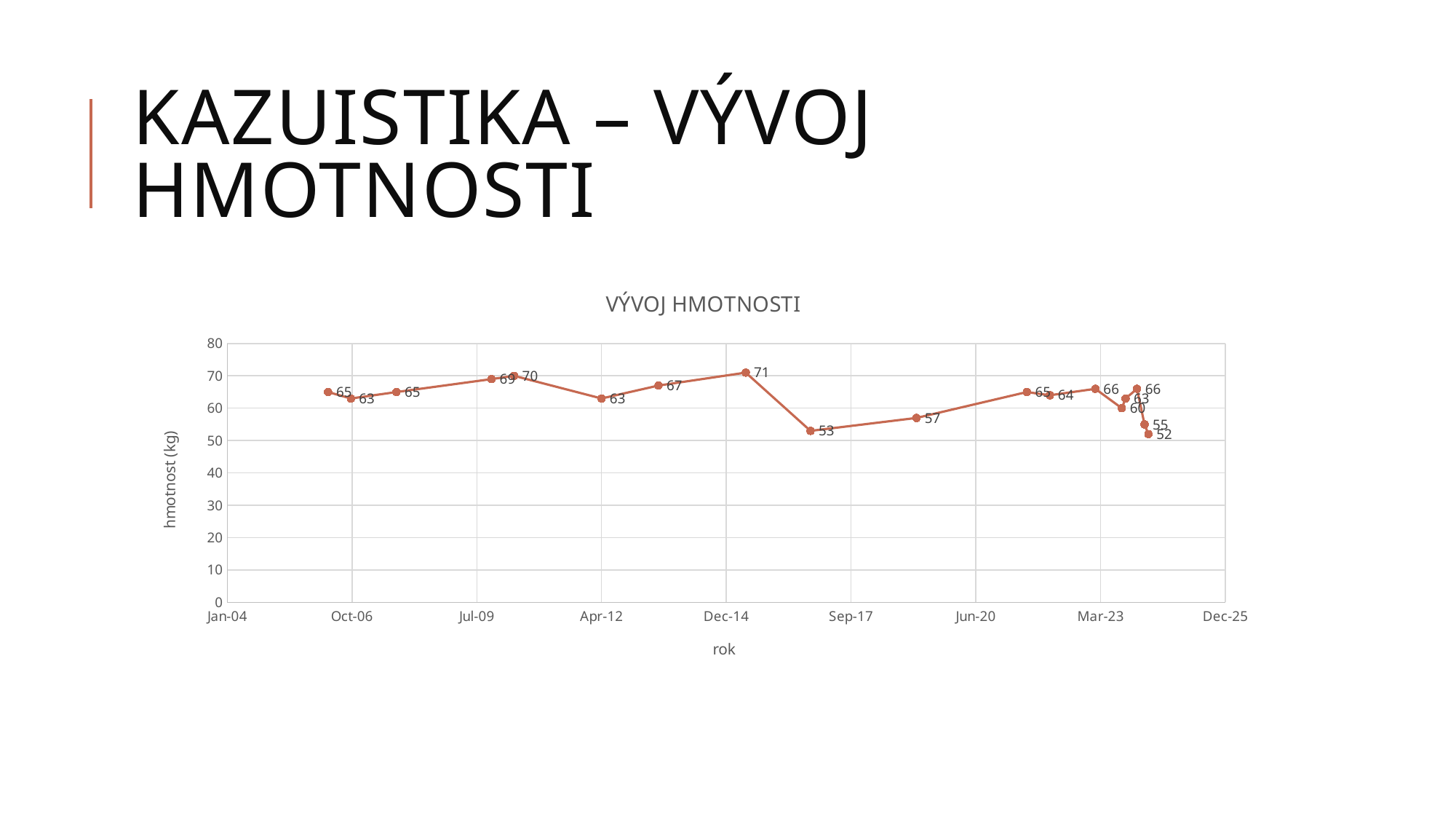
What is the difference between the highest and lowest values on the chart? 19 What is the difference between the first data point (65) and the last data point (52)? 13 Comparing the first data point and the last data point, does the value rise or fall over time? fall What is the highest value plotted on the chart? 71 Is the value of the data point just after Dec-14 greater or less than 70? greater What is the value of the first (leftmost) data point on the chart? 65 What kind of chart is shown on the slide? line chart How many data points are plotted on the chart? 18 What is the title of the chart? VÝVOJ HMOTNOSTI What is the value of the last (rightmost) data point on the chart? 52 What is the lowest value plotted on the chart? 52 What is the label of the vertical axis of the chart? hmotnost (kg)